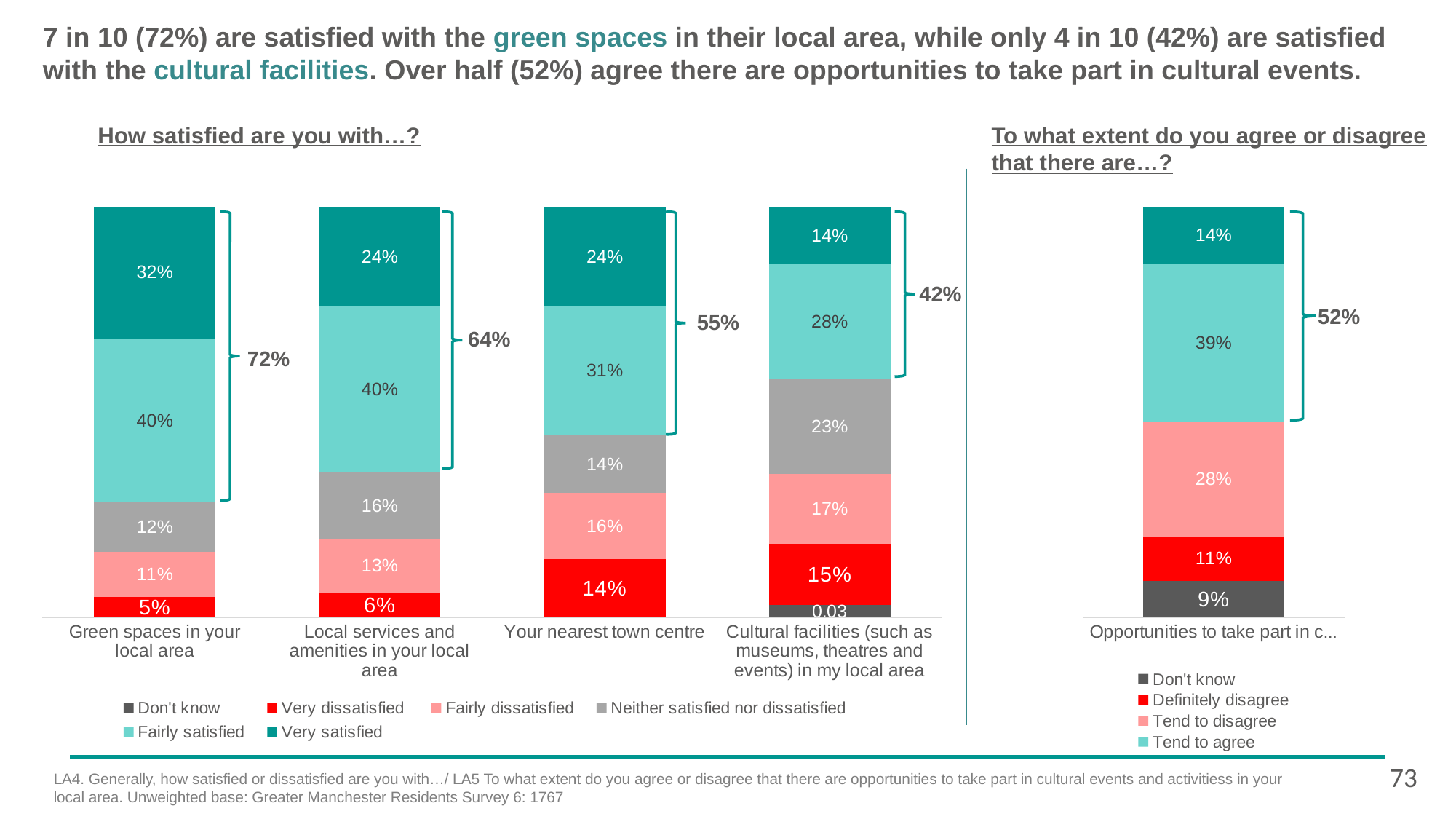
How many series does the legend of the 'How satisfied are you with…?' chart list? 6 In the 'How satisfied are you with…?' chart, what percentage are very satisfied with green spaces in their local area? 32% In the 'How satisfied are you with…?' chart, which category has the highest combined satisfied percentage? Green spaces in your local area What kind of chart is the 'To what extent do you agree or disagree that there are…?' chart? Stacked bar chart In the 'How satisfied are you with…?' chart, what percentage are very dissatisfied with their nearest town centre? 14% In the 'To what extent do you agree or disagree that there are…?' chart, what percentage tend to agree that there are opportunities to take part in cultural events? 39% How many categories are shown in the 'How satisfied are you with…?' chart? 4 In the 'How satisfied are you with…?' chart, what percentage are fairly satisfied with local services and amenities in their local area? 40% In the 'How satisfied are you with…?' chart, what is the combined satisfied percentage shown for cultural facilities? 42% In the 'How satisfied are you with…?' chart, what is the difference between the very satisfied percentage for green spaces and for cultural facilities? 18 percentage points In the 'How satisfied are you with…?' chart, which category has the lowest combined satisfied percentage? Cultural facilities (such as museums, theatres and events) in my local area In the 'How satisfied are you with…?' chart, is the neither satisfied nor dissatisfied percentage larger for cultural facilities or for green spaces? Cultural facilities